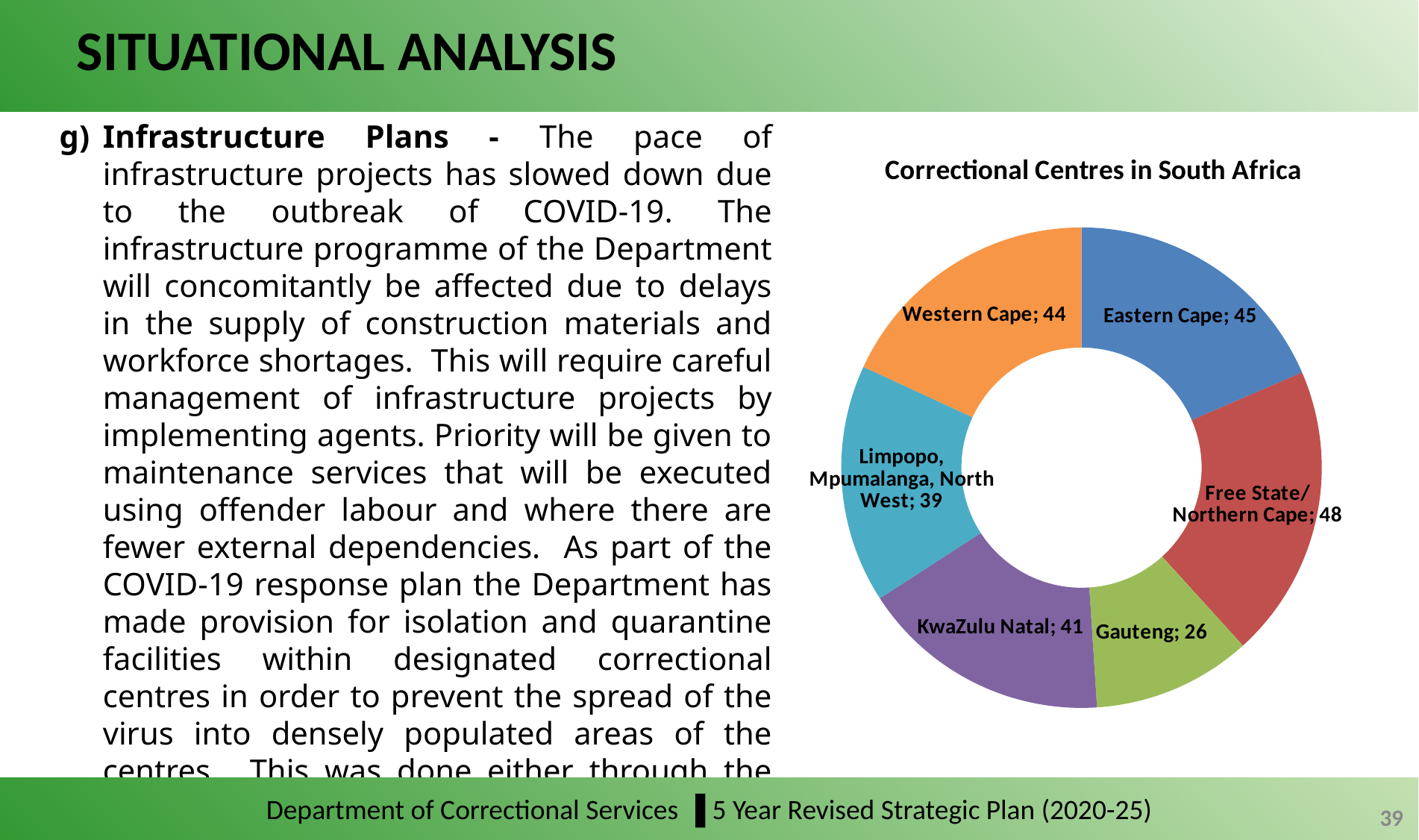
What type of chart is shown on the slide? doughnut chart What is the difference between the values for Free State/ Northern Cape and Gauteng? 22 How many correctional centres does the chart show for Eastern Cape? 45 Which has more correctional centres, Western Cape or KwaZulu Natal? Western Cape What is the total number of correctional centres across all slices of the chart? 243 What value is shown for Limpopo, Mpumalanga, North West? 39 Which region has the highest number of correctional centres in the chart? Free State/ Northern Cape What is the title of the chart on the slide? Correctional Centres in South Africa What value is shown for Gauteng in the chart? 26 How many regions (slices) are shown in the chart? 6 Which region has the lowest number of correctional centres in the chart? Gauteng What colour is the Western Cape slice in the chart? orange